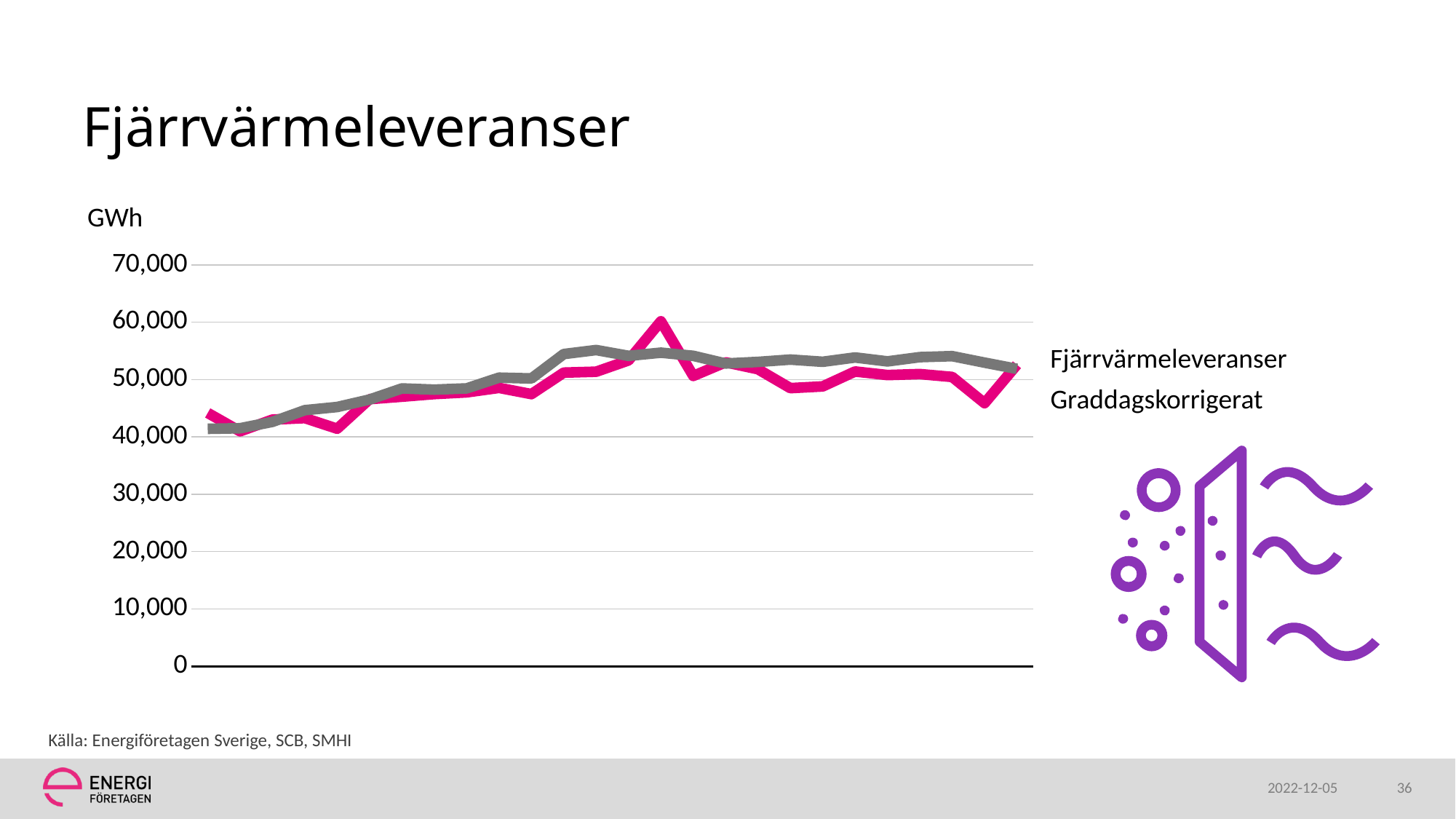
Is the highest value of the Fjärrvärmeleveranser line greater or less than 50,000? greater What is the highest value labelled on the y axis of the chart? 70,000 Which series is drawn in pink? Fjärrvärmeleveranser What kind of chart is shown on the slide? line chart How many series does the chart's legend list? 2 Is the highest value of the Graddagskorrigerat line greater or less than 60,000? less What is the title of the chart on the slide? Fjärrvärmeleveranser At the highest peak of the chart, which series has the larger value, Fjärrvärmeleveranser or Graddagskorrigerat? Fjärrvärmeleveranser Do the values of the Graddagskorrigerat line generally rise or fall from the left to the right of the chart? rise Is the first value of the Graddagskorrigerat line greater or less than 50,000? less